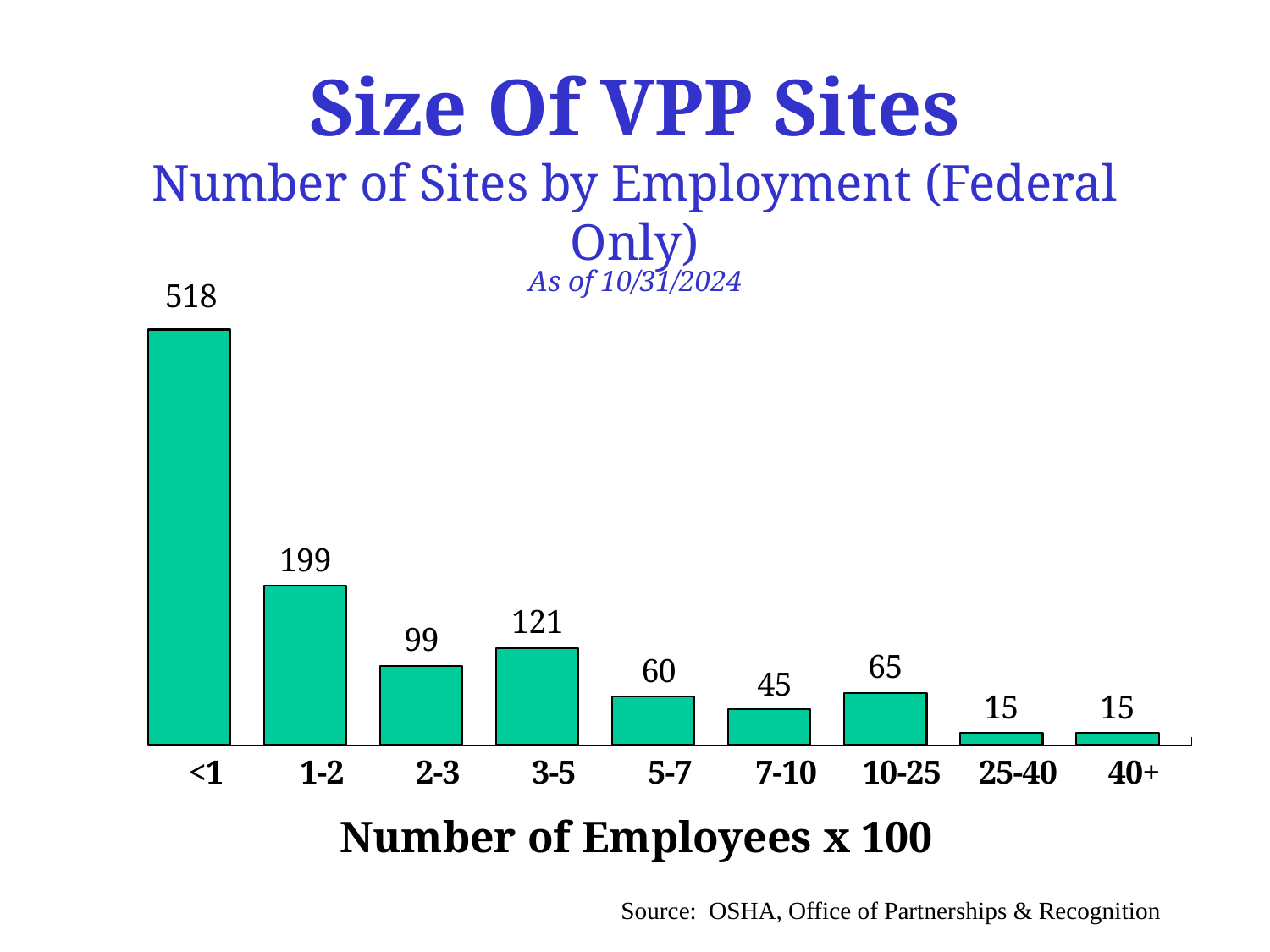
Which has more sites, the '5-7' category or the '10-25' category? 10-25 Which employment category has the highest number of sites? <1 What is the source cited for the chart data? OSHA, Office of Partnerships & Recognition What kind of chart is shown on the slide? Bar chart What is the difference between the number of sites in the '<1' category and the '1-2' category? 319 What is the label of the x axis? Number of Employees x 100 What is the number of sites in the '3-5' employment category? 121 What is the value shown for the '10-25' category? 65 How many VPP sites have fewer than 100 employees (the '<1' category)? 518 What is the difference between the '3-5' and '2-3' categories? 22 How many employment categories are shown on the x axis? 9 What is the lowest value shown on the chart? 15